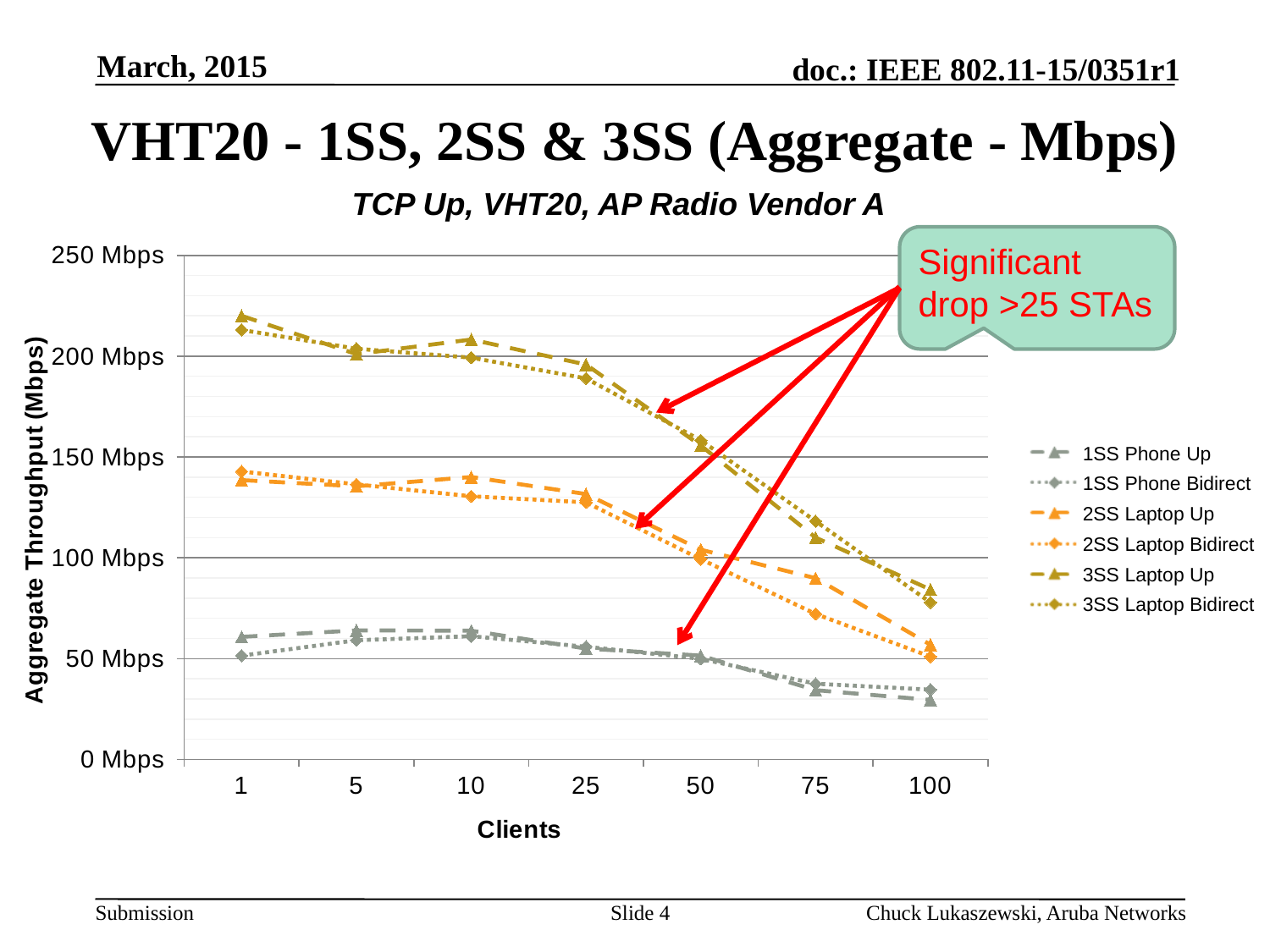
What is the label of the y axis? Aggregate Throughput (Mbps) Is the value for 1SS Phone Up at 100 clients greater or less than 50 Mbps? less At 100 clients, which is higher: 3SS Laptop Up or 1SS Phone Up? 3SS Laptop Up What is the title of the chart? TCP Up, VHT20, AP Radio Vendor A What kind of chart is shown on the slide? line chart How many series does the legend list? 6 Which series has the highest value at 1 client? 3SS Laptop Up Is the value for 3SS Laptop Bidirect at 75 clients greater or less than 100 Mbps? greater Is the value for 3SS Laptop Up at 1 client greater or less than 200 Mbps? greater Does the 3SS Laptop Up series rise or fall as the number of clients increases from 25 to 100? fall How many client counts are plotted along the x axis? 7